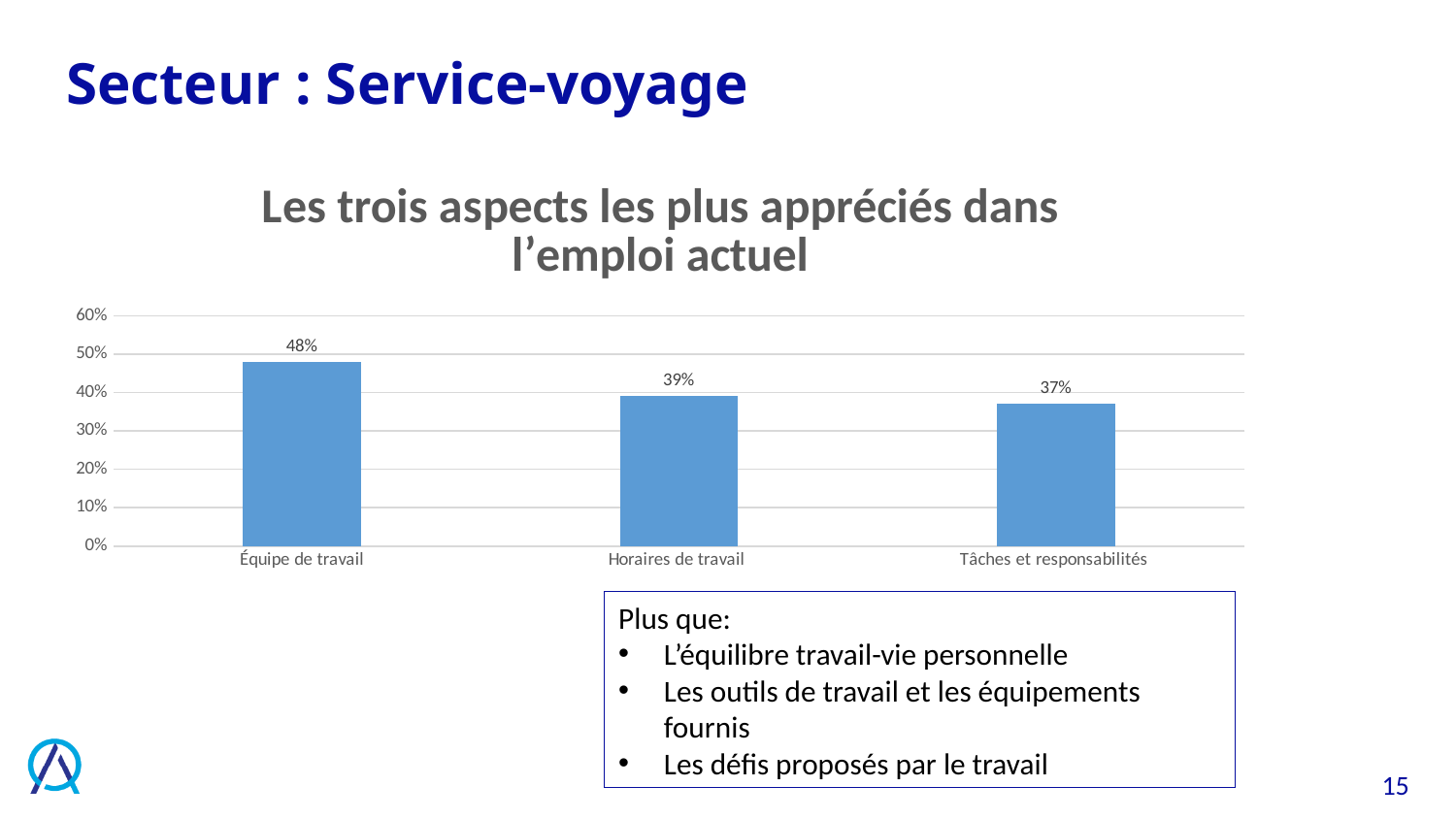
What is the difference between the values for Équipe de travail and Horaires de travail? 9% What is the difference between the values for Horaires de travail and Tâches et responsabilités? 2% Is the value for Horaires de travail greater or less than 50%? less What is the value for Équipe de travail? 48% What is the value for Horaires de travail? 39% How many categories are shown in the chart? 3 Which category has the lowest value? Tâches et responsabilités Which is larger, the value for Équipe de travail or the value for Tâches et responsabilités? Équipe de travail Which category has the highest value? Équipe de travail What is the value for Tâches et responsabilités? 37% What is the title of the chart? Les trois aspects les plus appréciés dans l'emploi actuel What kind of chart is shown on the slide? bar chart